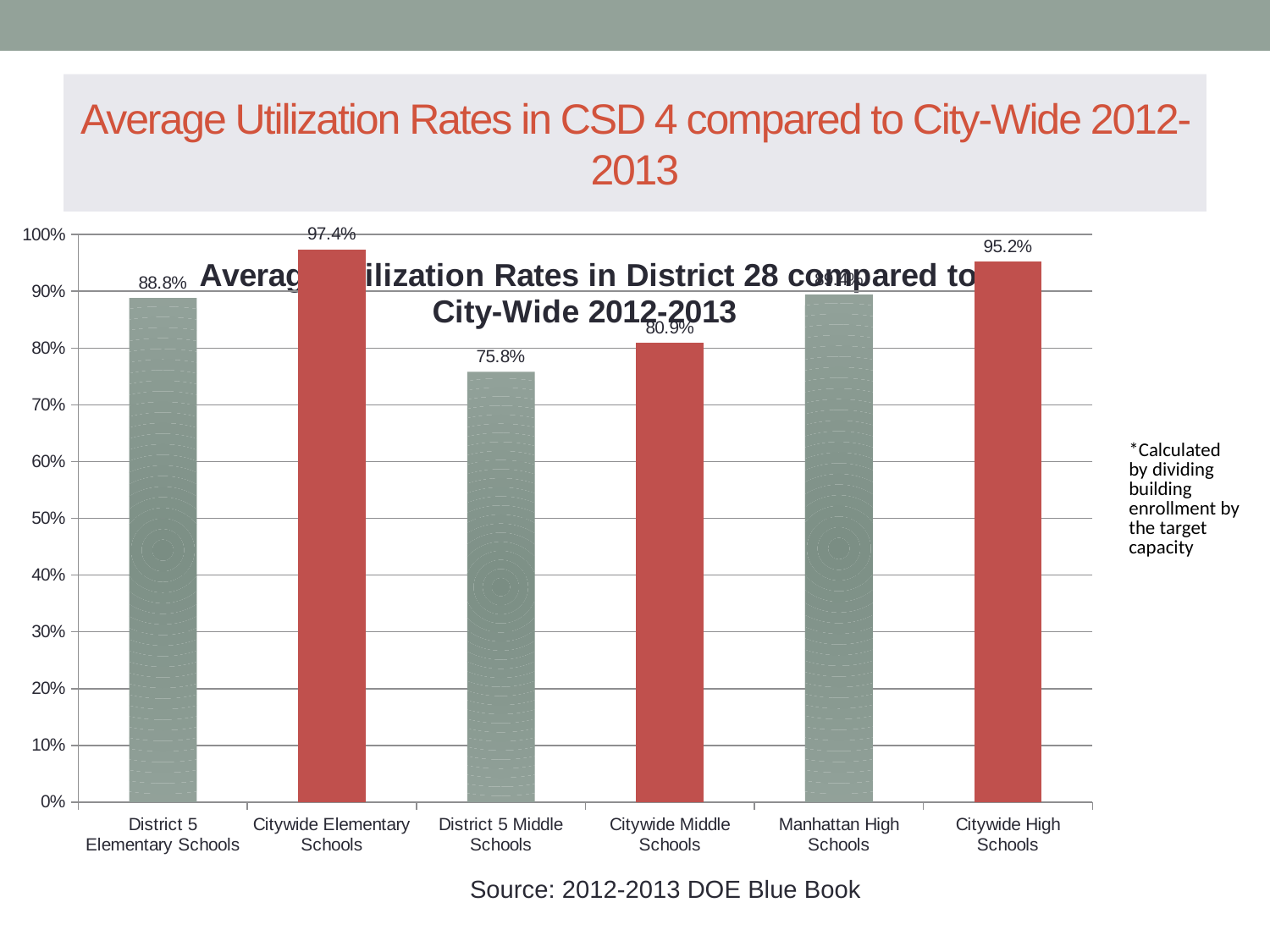
What is the average utilization rate for District 5 Middle Schools? 75.8% What kind of chart is shown on the slide? bar chart Which category has the lowest utilization rate? District 5 Middle Schools How many categories are shown on the x axis of the chart? 6 What is the average utilization rate for Citywide Middle Schools? 80.9% Which is larger, the utilization rate for Citywide Middle Schools or for District 5 Middle Schools? Citywide Middle Schools Is the utilization rate for Manhattan High Schools greater or less than 80%? greater What is the average utilization rate for Citywide Elementary Schools? 97.4% What is the average utilization rate for Citywide High Schools? 95.2% Which category has the highest utilization rate? Citywide Elementary Schools What is the average utilization rate for District 5 Elementary Schools? 88.8% How much higher is the utilization rate for Citywide Elementary Schools than for District 5 Elementary Schools? 8.6 percentage points